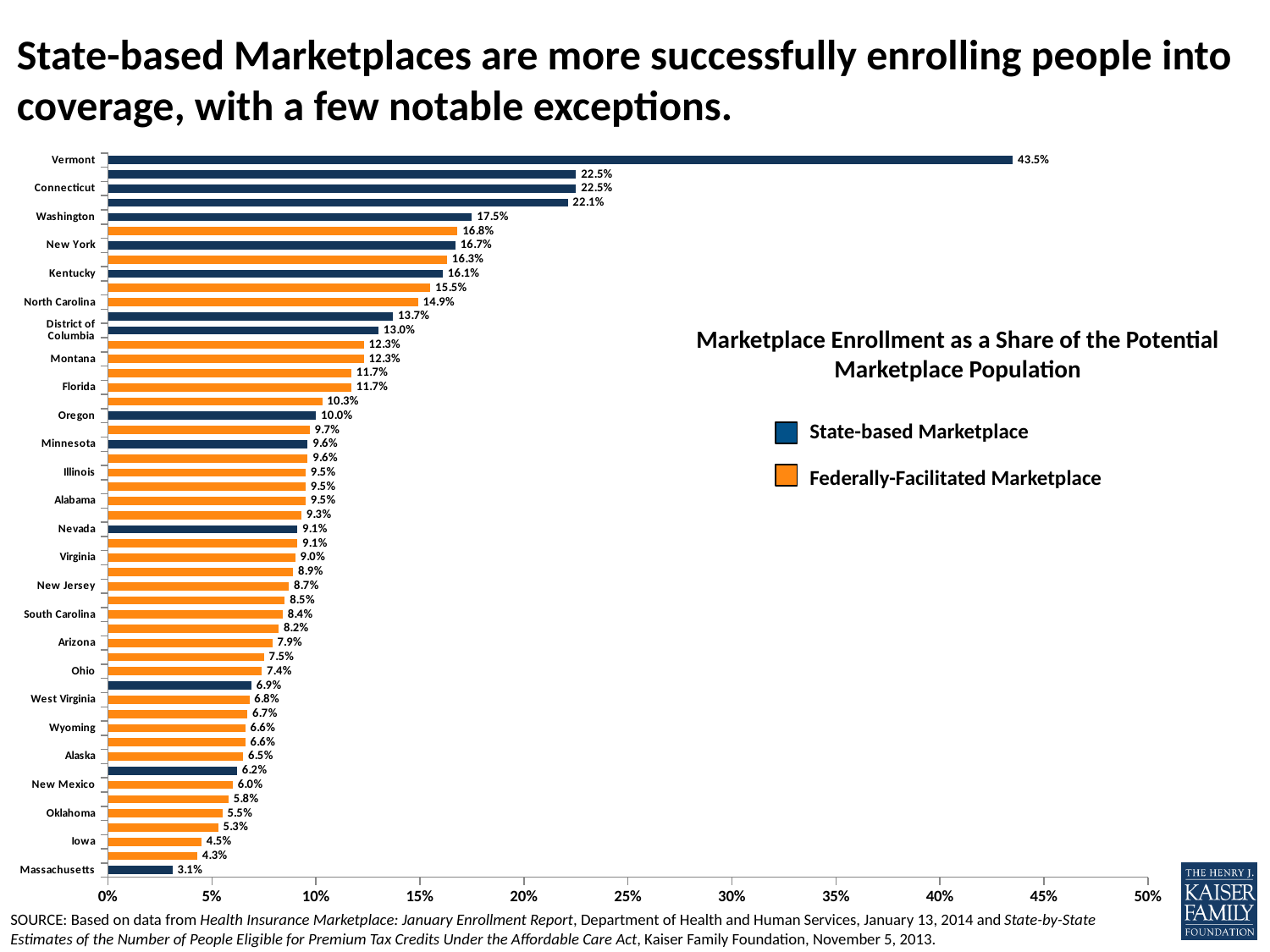
What is the value for Massachusetts? 3.1% What is the value for Florida? 11.7% What is the value for Vermont? 43.5% Is the value for Oregon greater or less than 15%? less What kind of chart is shown on the slide? Bar chart What is the difference between the values for Vermont and Connecticut? 21.0 percentage points How many series does the legend list? 2 Which state has the highest marketplace enrollment share? Vermont Which labeled state has the lowest marketplace enrollment share? Massachusetts What colour represents the State-based Marketplace in the legend? Dark blue What is the value for Kentucky? 16.1% Which is larger, the value for Washington or the value for New York? Washington